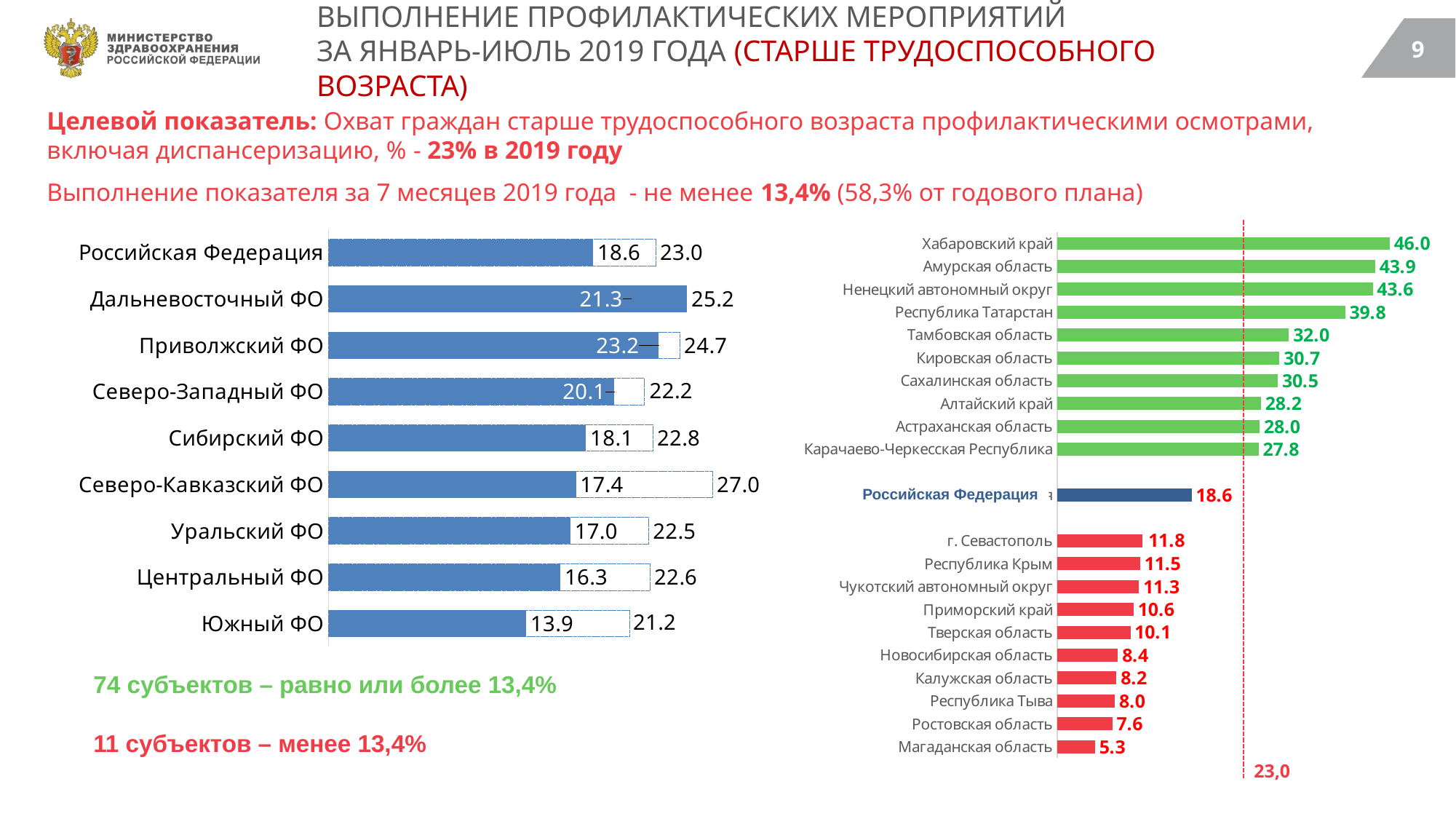
On the right chart, what is the value for Республика Татарстан? 39.8 On the left chart, what is the first (blue bar) value shown for Южный ФО? 13.9 On the left chart, what is the second value shown for Северо-Кавказский ФО? 27.0 On the right chart, what is the difference between the values for Хабаровский край and Магаданская область? 40.7 On the right chart, which is larger: the value for Кировская область or Сахалинская область? Кировская область On the right chart, what is the value for Чукотский автономный округ? 11.3 On the right chart, which region has the lowest value? Магаданская область On the left chart, which federal district has the highest blue bar value? Дальневосточный ФО On the left chart, what is the difference between the two values shown for Российская Федерация? 4.4 On the left chart, how many categories are plotted? 9 On the right chart, which region has the highest value? Хабаровский край What type of chart is the right chart? Bar chart